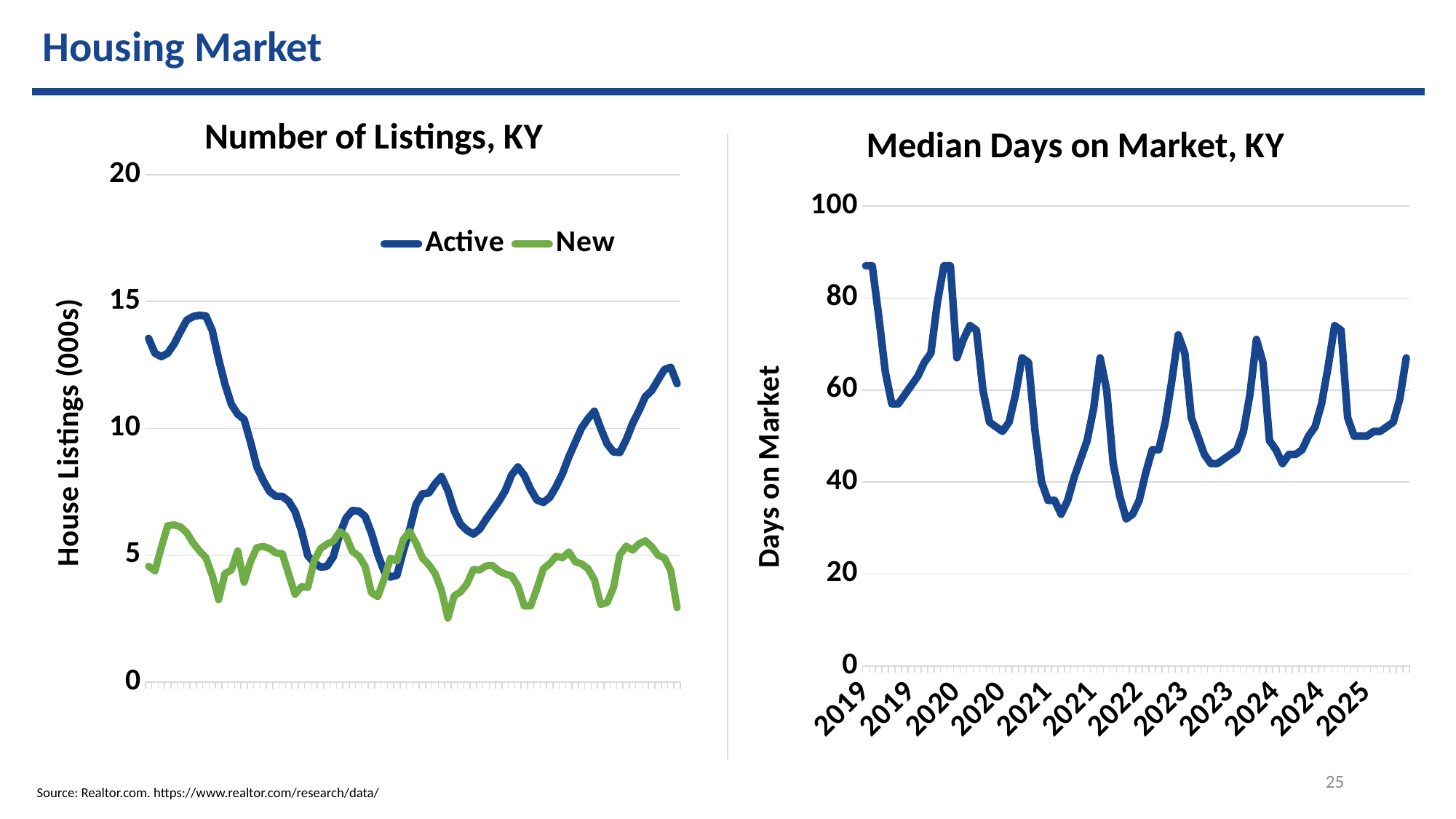
What kind of chart is the "Number of Listings, KY" chart? line chart In the "Number of Listings, KY" chart, is the highest value of the Active series greater or less than 10? greater What kind of chart is the "Median Days on Market, KY" chart? line chart In the "Median Days on Market, KY" chart, do the values overall rise or fall from the start of 2019 to the start of 2021? fall How many series does the legend of the "Number of Listings, KY" chart list? 2 What is the y-axis label of the "Median Days on Market, KY" chart? Days on Market What are the two series named in the legend of the "Number of Listings, KY" chart? Active and New In the "Median Days on Market, KY" chart, is the value at the start of 2019 greater or less than 80? greater In the "Number of Listings, KY" chart, which series starts higher at the left edge of the chart, Active or New? Active In the "Number of Listings, KY" chart, is the highest value of the New series greater or less than 10? less